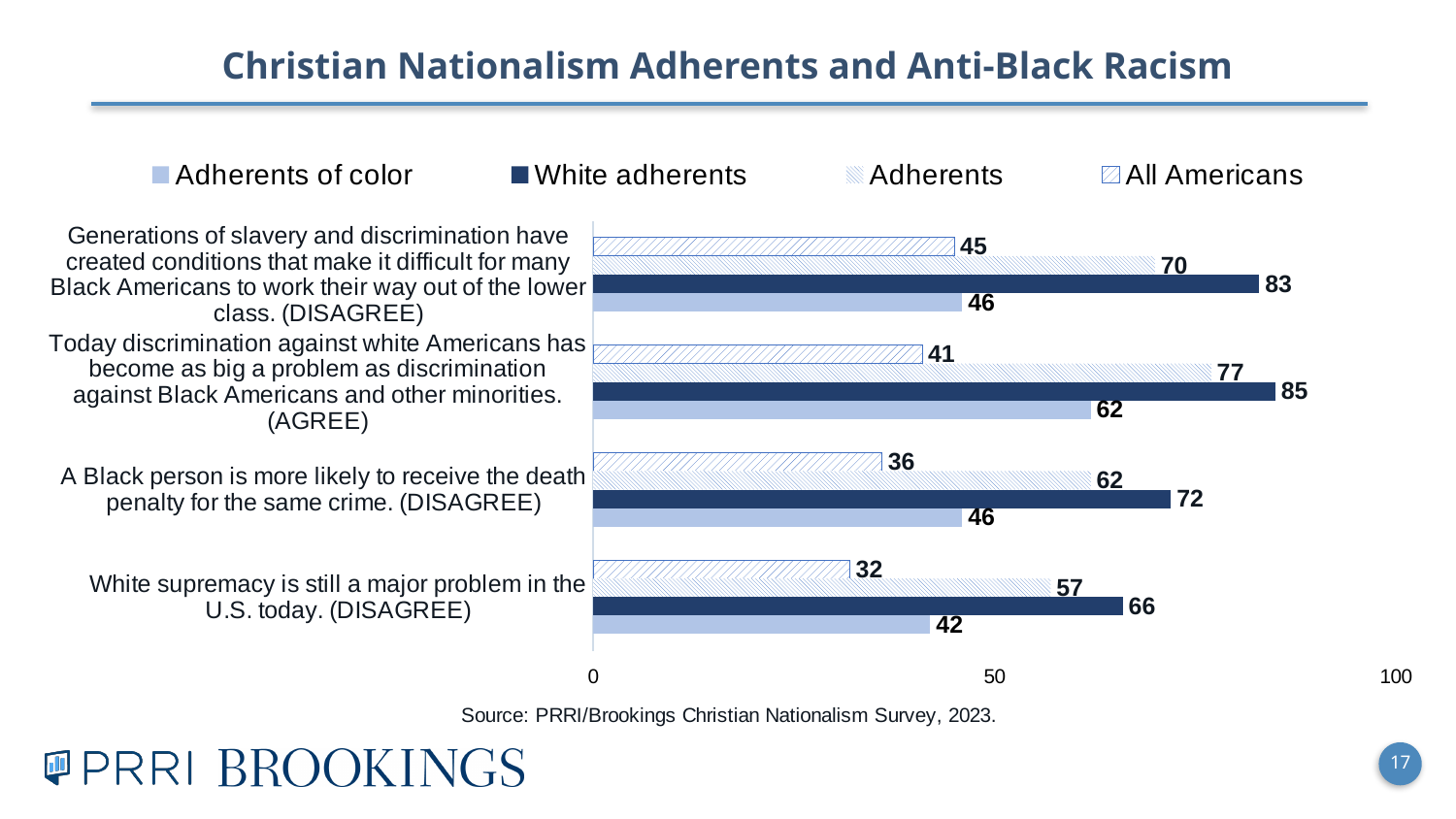
What kind of chart is shown on the slide? Bar chart How many statements (categories) are shown in the chart? 4 What is the value for Adherents on the statement "Generations of slavery and discrimination have created conditions that make it difficult for many Black Americans to work their way out of the lower class. (DISAGREE)"? 70 What is the value for White adherents on the statement "White supremacy is still a major problem in the U.S. today. (DISAGREE)"? 66 What is the value for All Americans on the statement "Today discrimination against white Americans has become as big a problem as discrimination against Black Americans and other minorities. (AGREE)"? 41 Which statement has the highest value for White adherents? Today discrimination against white Americans has become as big a problem as discrimination against Black Americans and other minorities. (AGREE) Which statement has the lowest value for All Americans? White supremacy is still a major problem in the U.S. today. (DISAGREE) On the statement "Today discrimination against white Americans has become as big a problem as discrimination against Black Americans and other minorities. (AGREE)", which is larger: Adherents of color or Adherents? Adherents Is the value for Adherents of color on the statement "White supremacy is still a major problem in the U.S. today. (DISAGREE)" greater or less than 50? less What is the difference between White adherents and All Americans on the statement "A Black person is more likely to receive the death penalty for the same crime. (DISAGREE)"? 36 How many series does the legend list? 4 What is the value for Adherents of color on the statement "A Black person is more likely to receive the death penalty for the same crime. (DISAGREE)"? 46